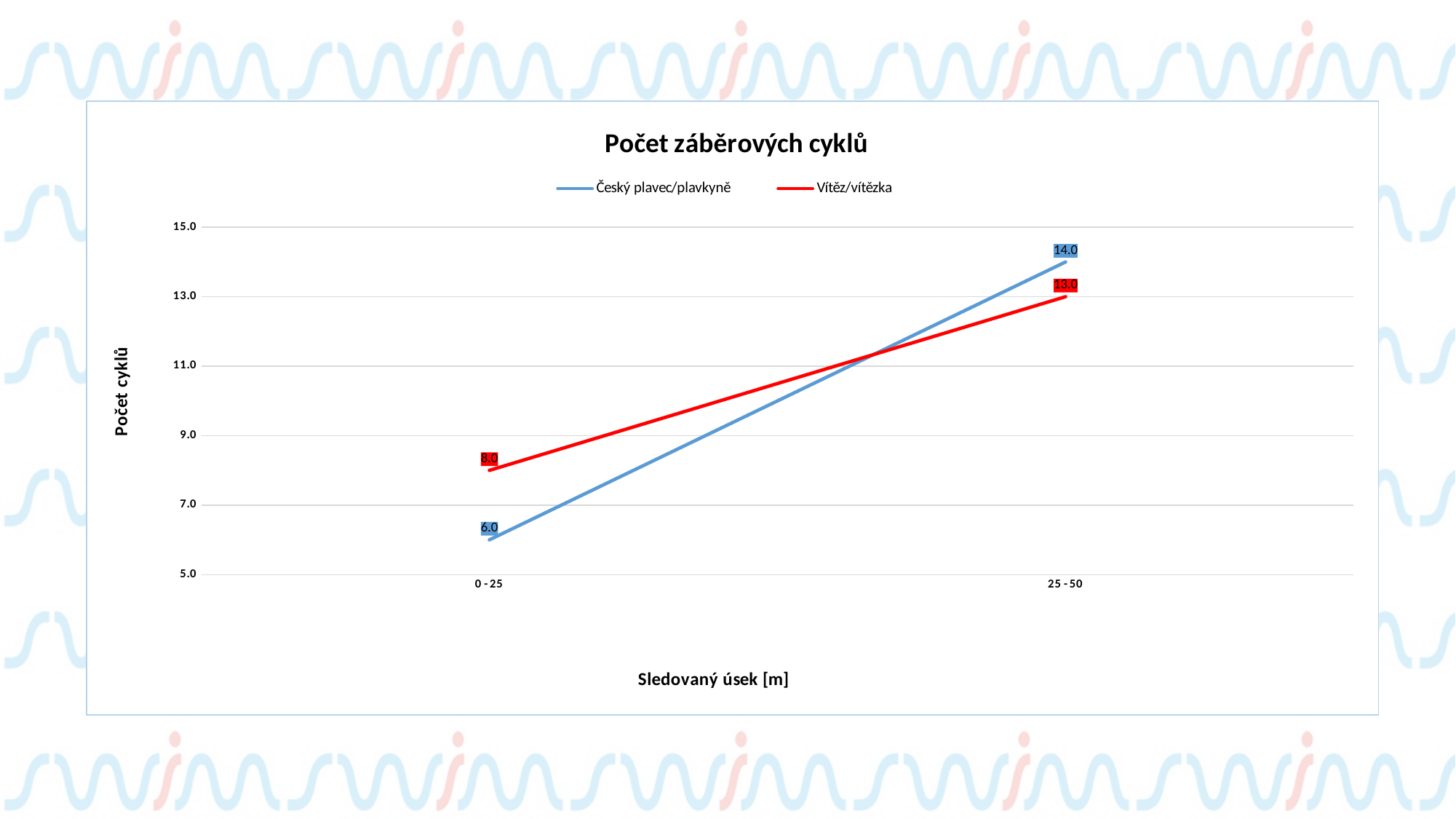
What is the difference between the Český plavec/plavkyně values at 25 - 50 and 0 - 25? 8.0 What is the difference between the Vítěz/vítězka and Český plavec/plavkyně values at 0 - 25? 2.0 What is the value for Vítěz/vítězka at 0 - 25? 8.0 How many series does the legend list? 2 Which series has the higher value at 25 - 50? Český plavec/plavkyně Do the values for Vítěz/vítězka rise or fall from 0 - 25 to 25 - 50? rise What kind of chart is this? line chart What is the value for Český plavec/plavkyně at 25 - 50? 14.0 What is the value for Český plavec/plavkyně at 0 - 25? 6.0 How many categories are shown on the x axis? 2 What is the value for Vítěz/vítězka at 25 - 50? 13.0 Which series has the higher value at 0 - 25? Vítěz/vítězka